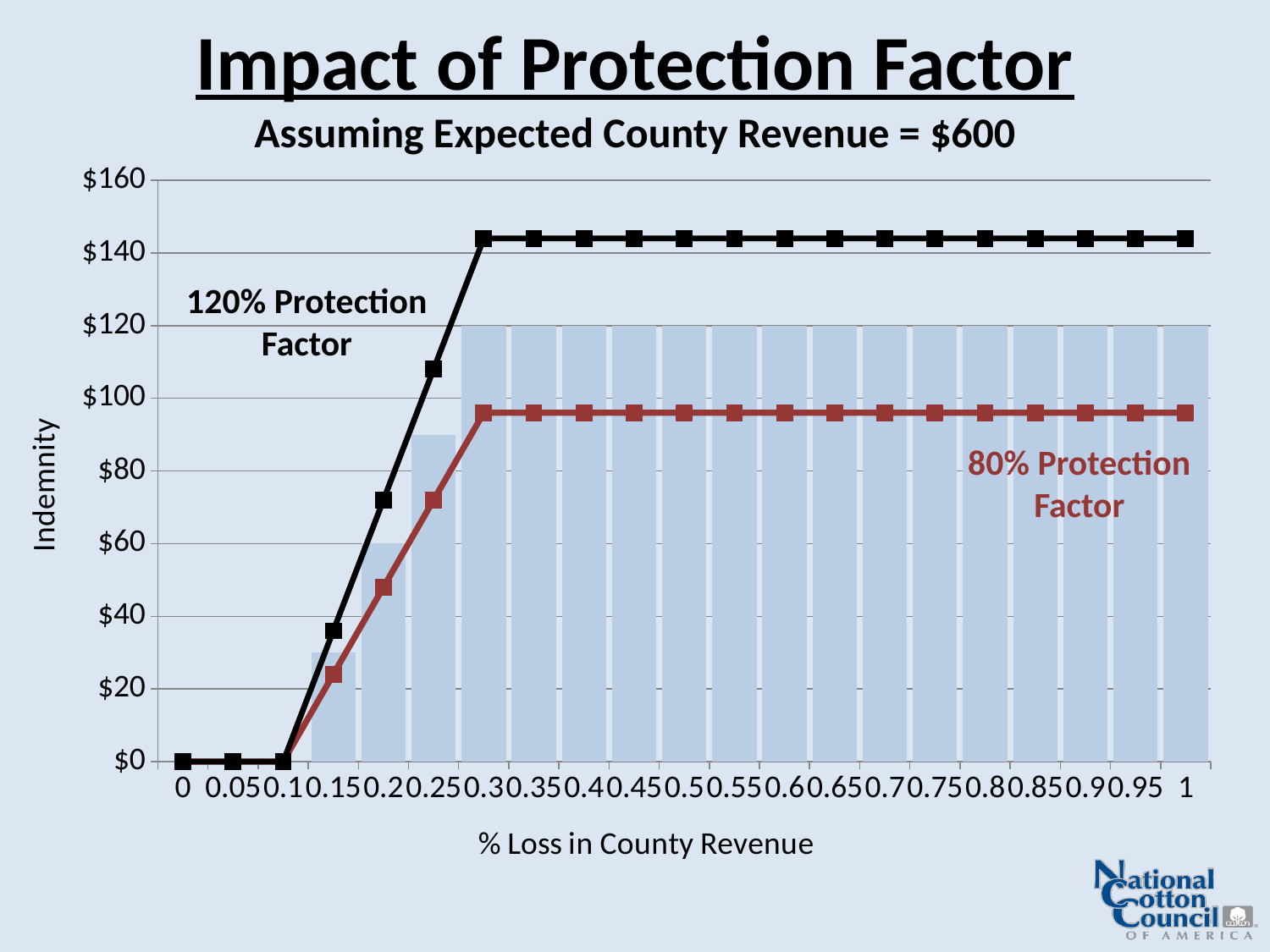
What is the indemnity for the 120% Protection Factor line at a 0 loss in county revenue? $0 What is the indemnity for the 80% Protection Factor line at a 0.05 loss in county revenue? $0 Is the value for the 120% Protection Factor line at a loss of 1 greater or less than $120? greater What is the title of the chart? Impact of Protection Factor What kind of chart is shown on the slide? combination bar and line chart Is the value for the 80% Protection Factor line at a loss of 0.5 greater or less than $80? greater How many points are marked along the x axis from 0 to 1? 21 Is the value for the 120% Protection Factor line at a loss of 0.15 greater or less than $40? less Which line reaches the higher plateau, the 120% Protection Factor or the 80% Protection Factor? 120% Protection Factor Does the 120% Protection Factor line rise or fall between a loss of 0.1 and a loss of 0.3? rise At a loss of 0.2, which line is higher, the 120% Protection Factor or the 80% Protection Factor? 120% Protection Factor What is the label of the x axis? % Loss in County Revenue